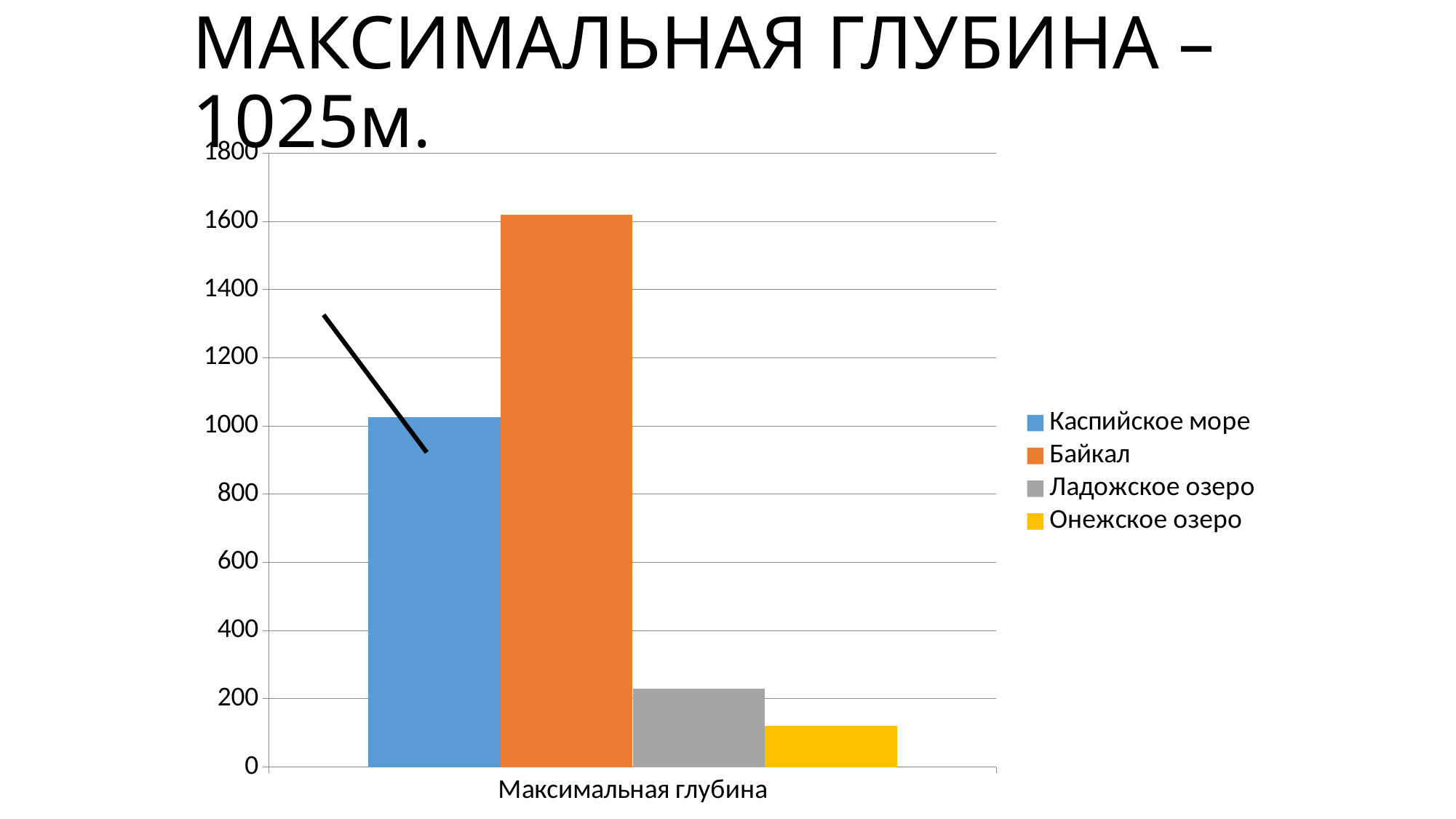
Is the value for Онежское озеро greater or less than 200? less How many series does the legend list? 4 Which is larger, the value for Ладожское озеро or the value for Онежское озеро? Ладожское озеро Which series has the lowest value for Максимальная глубина? Онежское озеро What kind of chart is shown on the slide? bar chart Which is larger, the value for Байкал or the value for Каспийское море? Байкал What is the category label on the x axis? Максимальная глубина What colour is the bar for Байкал? orange Which series has the highest value for Максимальная глубина? Байкал Is the value for Байкал greater or less than 1400? greater How many categories are shown on the x axis? 1 Is the value for Каспийское море greater or less than 800? greater